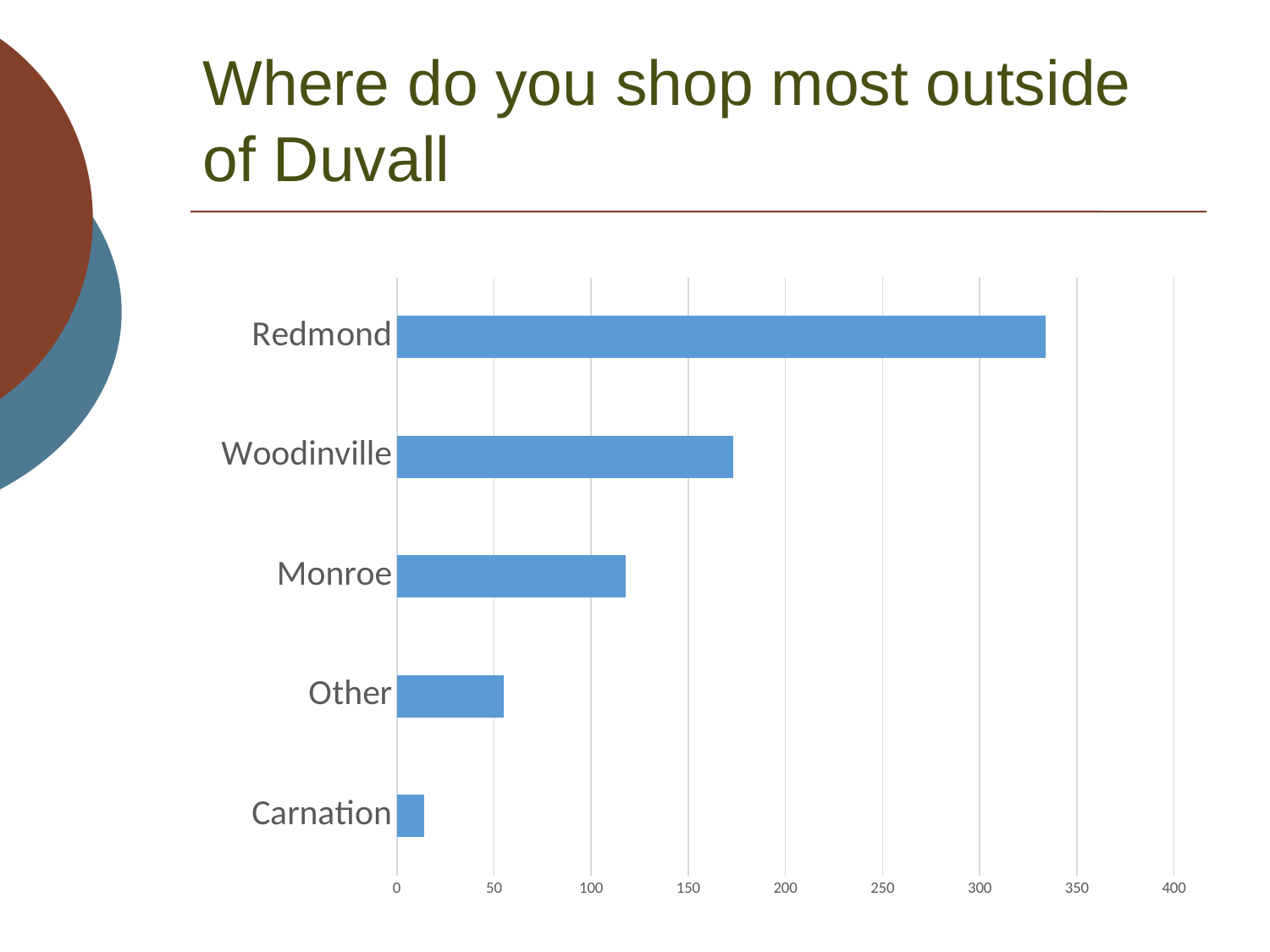
Is the value for Woodinville greater or less than 150? greater Is the value for Redmond greater or less than 300? greater Which category has the lowest value? Carnation Which category has the highest value? Redmond What is the title of the slide containing the chart? Where do you shop most outside of Duvall Which is larger, the value for Other or the value for Carnation? Other Is the value for Other greater or less than 100? less What kind of chart is shown on the slide? bar chart How many categories are shown in the chart? 5 Which is larger, the value for Woodinville or the value for Monroe? Woodinville